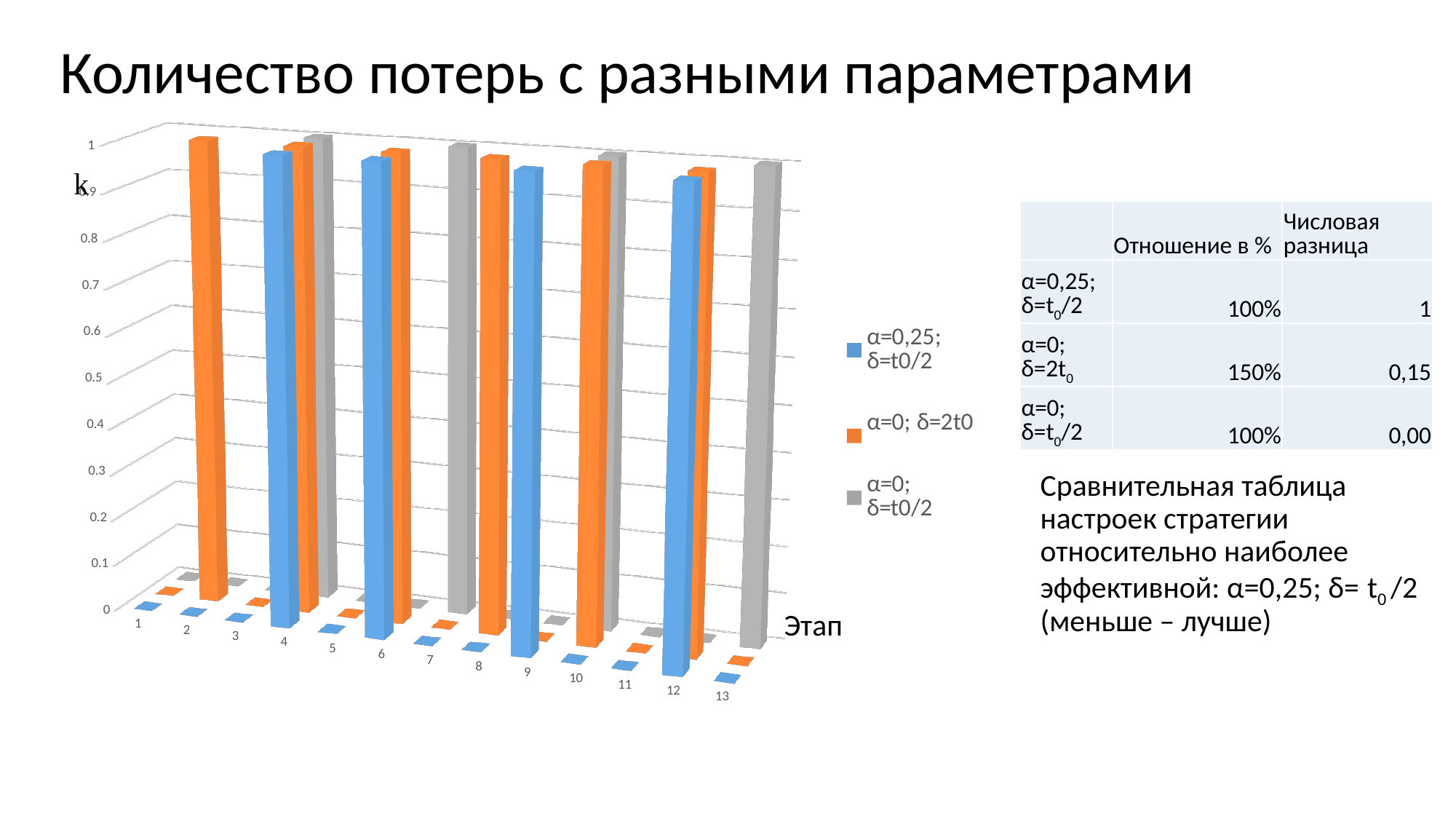
Is the value for series α=0,25; δ=t0/2 at stage 9 greater or less than 0.5? greater Which colour represents the series α=0; δ=2t0 in the chart? orange Is the value for series α=0,25; δ=t0/2 at stage 1 greater or less than 0.5? less What is the title of the chart on the slide? Количество потерь с разными параметрами What kind of chart is shown on the slide? bar chart Is the value for series α=0; δ=t0/2 at stage 13 greater or less than 0.5? greater How many series does the chart legend list? 3 At stage 2, which series has the larger value: α=0; δ=2t0 or α=0,25; δ=t0/2? α=0; δ=2t0 How many stages (Этап) are shown along the x axis of the chart? 13